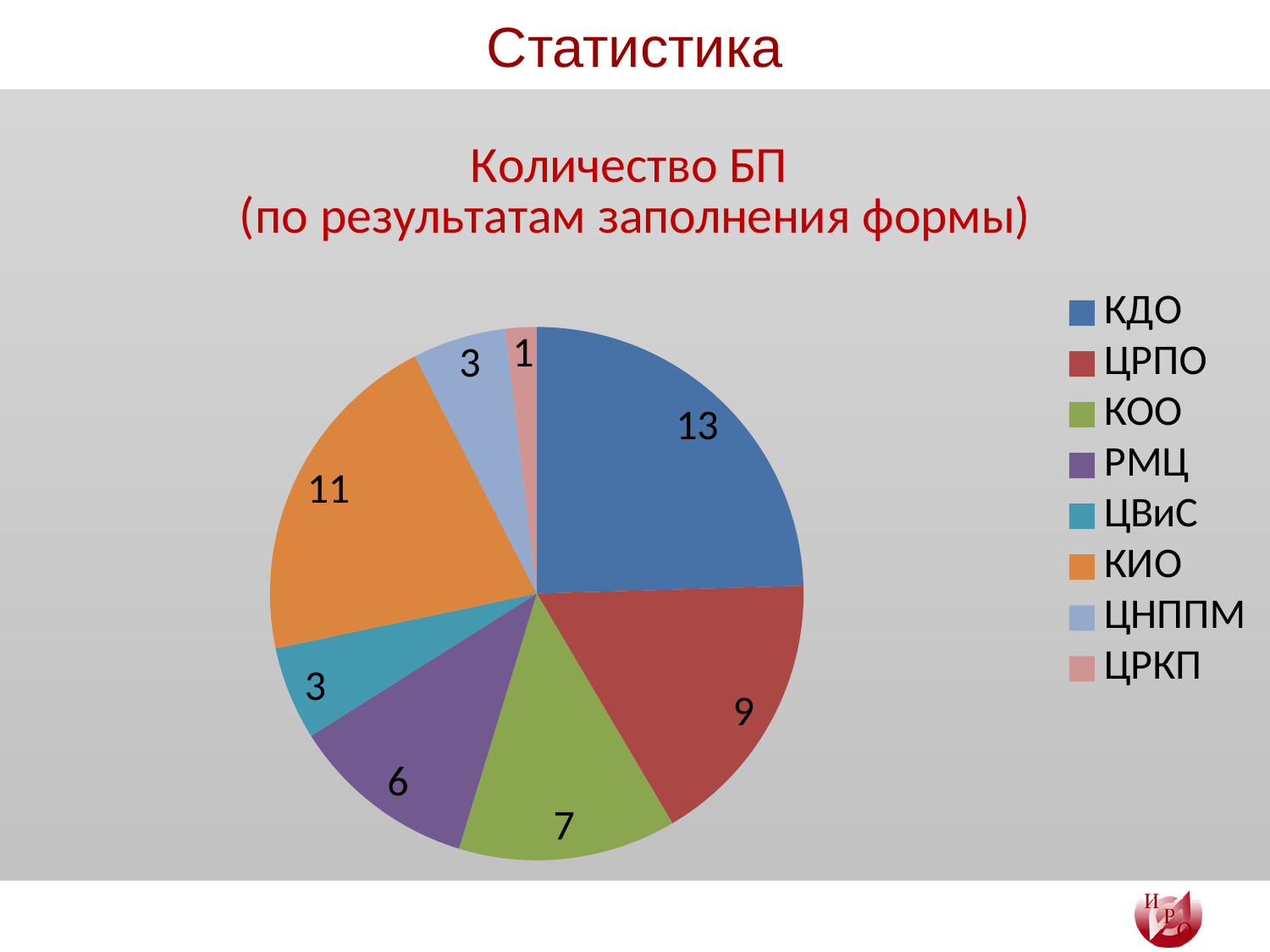
What is the value for ЦРКП in the pie chart? 1 What is the difference between the values for КДО and ЦРПО? 4 How many categories does the pie chart have? 8 Which is larger, the value for КОО or the value for КИО? КИО What is the total of all the values shown in the pie chart? 53 What is the value for РМЦ in the pie chart? 6 What is the value for КДО in the pie chart? 13 Which category has the smallest slice in the pie chart? ЦРКП What is the value for КИО in the pie chart? 11 What type of chart is shown on the slide? pie chart Which category has the largest slice in the pie chart? КДО What is the title of the chart? Количество БП (по результатам заполнения формы)